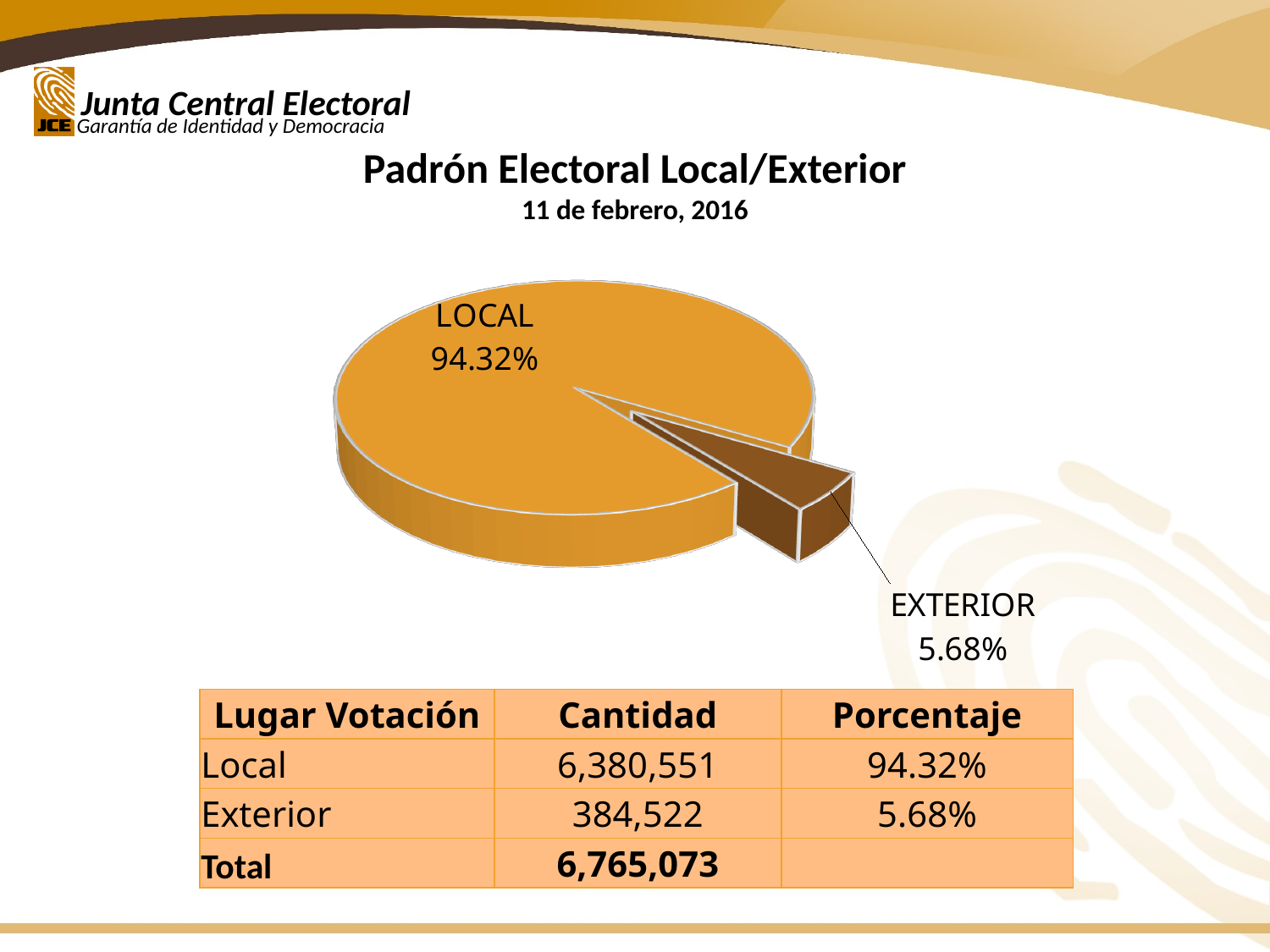
What is the difference in percentage points between the LOCAL and EXTERIOR slices? 88.64% Which slice of the pie is the largest? LOCAL What date is shown under the chart title? 11 de febrero, 2016 What share of the pie does the EXTERIOR slice represent? 5.68% Is the share of the EXTERIOR slice greater or less than 10%? less Is the share of the LOCAL slice greater or less than 90%? greater Which slice of the pie is the smallest? EXTERIOR Which is larger, the LOCAL slice or the EXTERIOR slice? LOCAL How many slices does the pie chart have? 2 What kind of chart is shown on the slide? Pie chart What is the title of the chart? Padrón Electoral Local/Exterior What share of the pie does the LOCAL slice represent? 94.32%